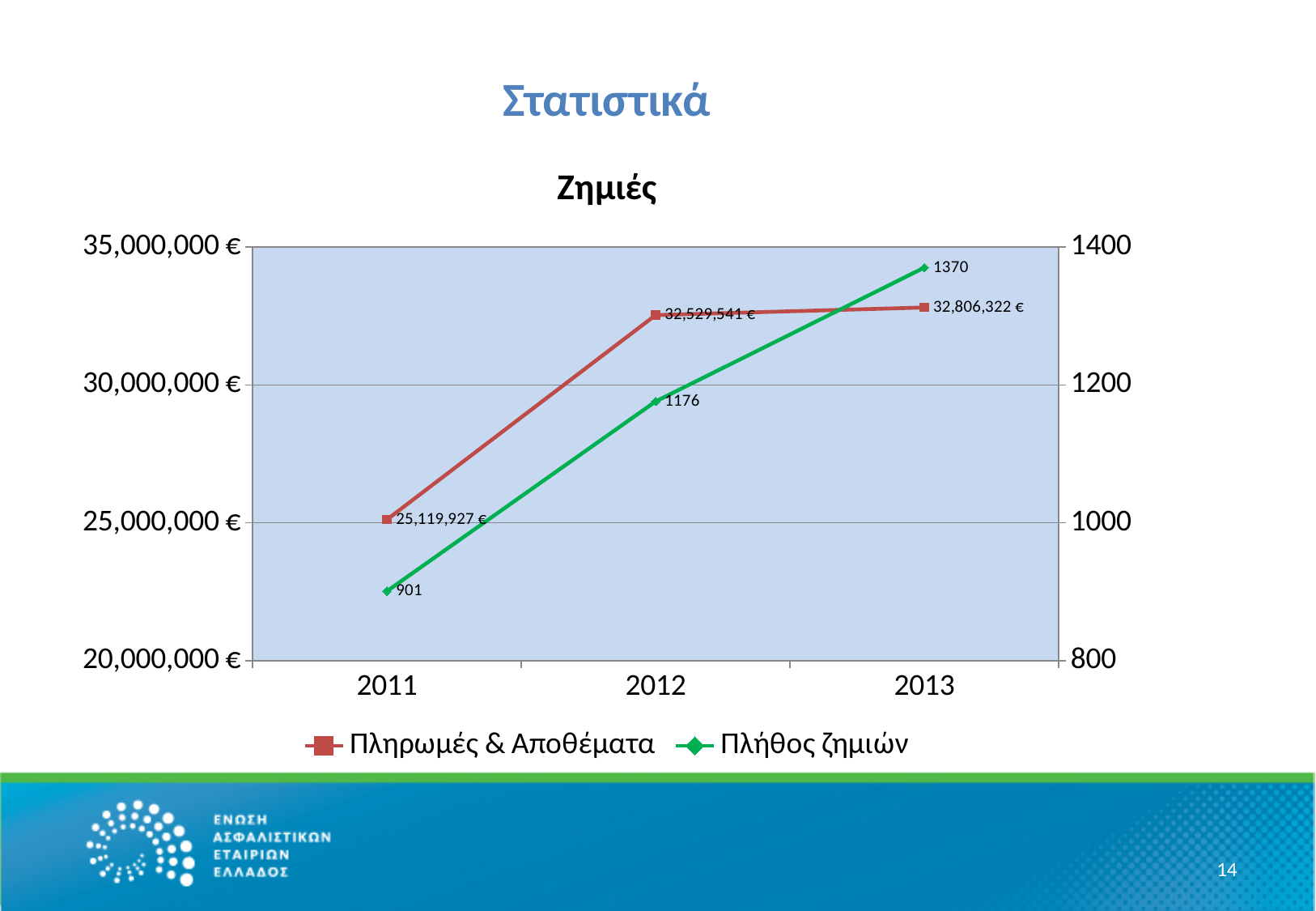
What is the title of the chart? Ζημιές In which year is Πληρωμές & Αποθέματα highest? 2013 Does Πλήθος ζημιών rise or fall from 2011 to 2013? rise How many series does the legend list? 2 What is the value of Πληρωμές & Αποθέματα in 2011? 25,119,927 € What is the difference between Πλήθος ζημιών in 2013 and in 2012? 194 In which year is Πλήθος ζημιών lowest? 2011 What is the value of Πλήθος ζημιών in 2012? 1176 What is the difference between Πληρωμές & Αποθέματα in 2012 and in 2011? 7,409,614 € How many years are plotted on the x axis? 3 What is the value of Πλήθος ζημιών in 2013? 1370 What type of chart is shown on the slide? line chart